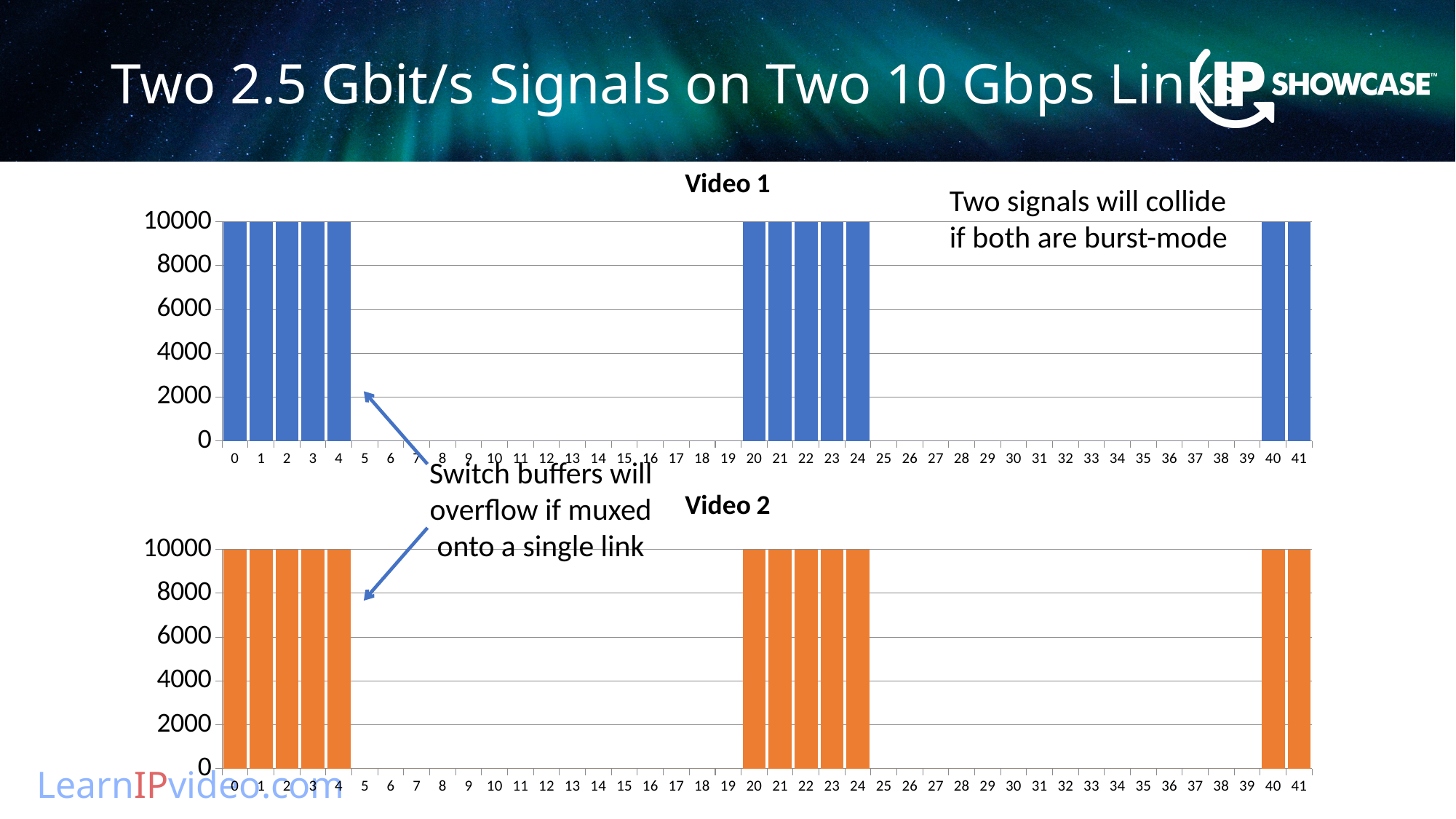
In the Video 1 chart, what is the value at x = 2? 10000 In the Video 2 chart, what is the value at x = 22? 10000 How many categories are shown on the x axis of the Video 2 chart? 42 In the Video 2 chart, what is the difference between the value at x = 0 and the value at x = 15? 10000 In the Video 1 chart, is the value at x = 20 greater or less than 8000? greater In the Video 1 chart, what is the value at x = 10? 0 In the Video 1 chart, which is larger, the value at x = 4 or the value at x = 5? x = 4 What colour are the bars in the Video 2 chart? orange In the Video 2 chart, what is the value at x = 41? 10000 In the Video 2 chart, is the value at x = 30 greater or less than 2000? less What type of chart is the Video 1 chart? bar chart What is the title of the top chart on the slide? Video 1